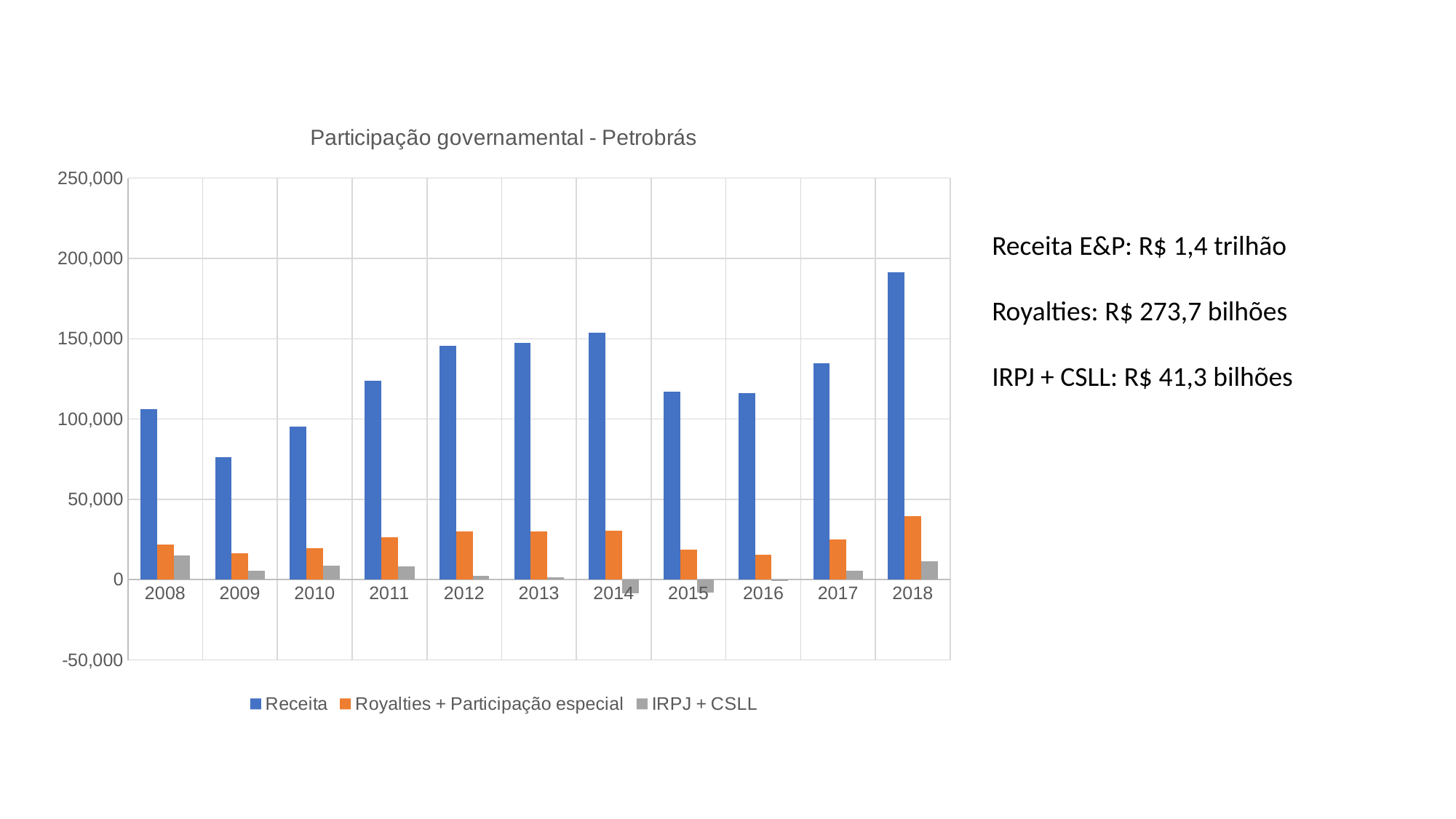
In which year is the Receita bar the lowest? 2009 What kind of chart is shown on the slide? Bar chart How many years are shown on the x axis of the chart? 11 Which year has the larger Receita value, 2011 or 2010? 2011 Is the Receita value for 2009 greater or less than 100,000? less In which year is the Royalties + Participação especial bar the highest? 2018 What is the title of the chart? Participação governamental - Petrobrás In which year is the Receita bar the highest? 2018 Does the Receita series rise or fall from 2015 to 2018? Rise How many series does the chart's legend list? 3 Is the Royalties + Participação especial value for 2018 greater or less than 50,000? less Is the Receita value for 2018 greater or less than 150,000? greater